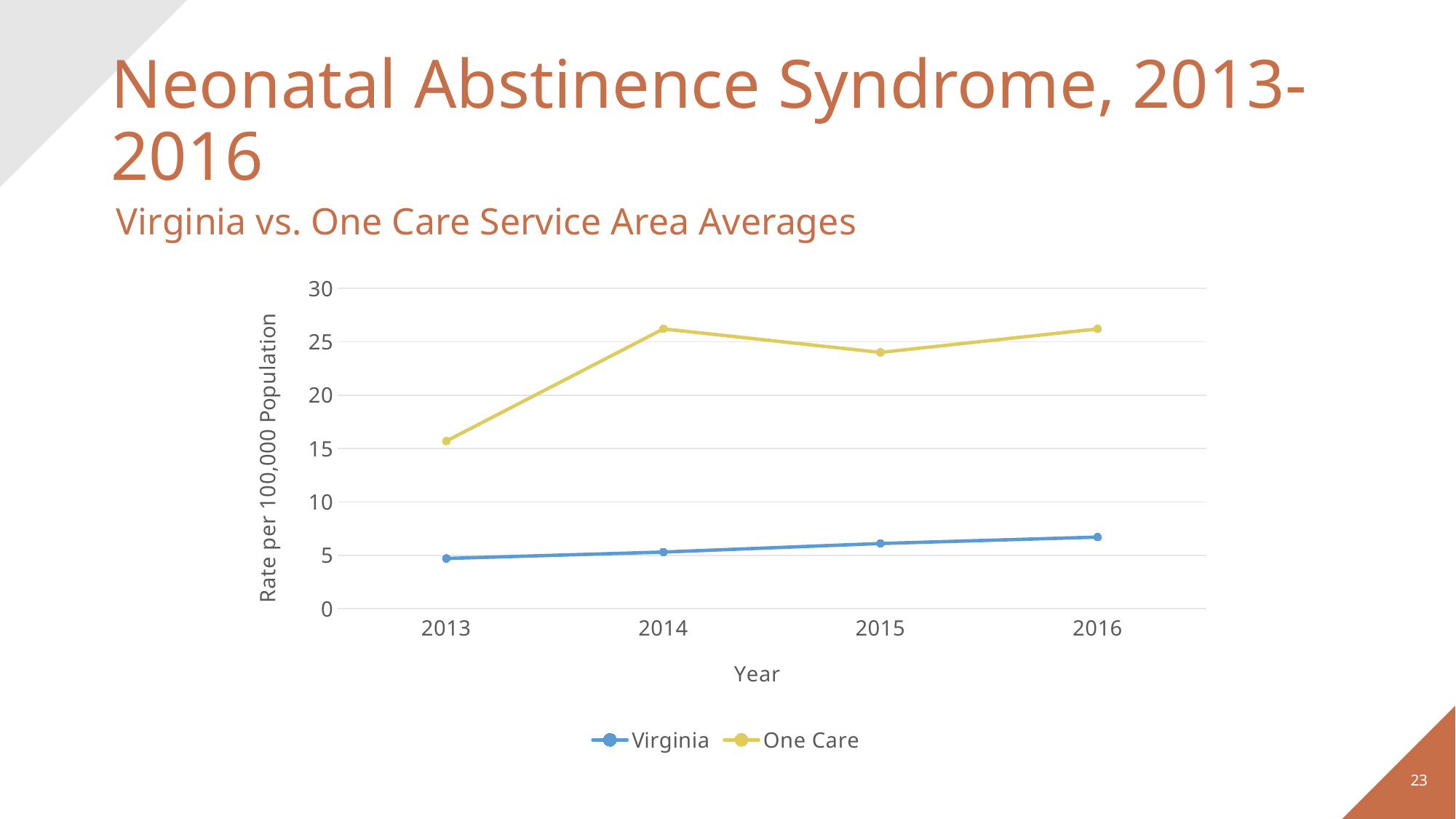
Does the Virginia line rise or fall from 2013 to 2016? rise Is the One Care value for 2013 greater or less than 20? less Is the One Care value for 2014 greater or less than 25? greater How many years are plotted on the x axis? 4 Is the One Care value for 2015 greater or less than 25? less Which series has the higher value in 2016, Virginia or One Care? One Care What kind of chart is shown on the slide? line chart In which year is the One Care rate lowest? 2013 What is the label of the y axis? Rate per 100,000 Population How many series does the legend list? 2